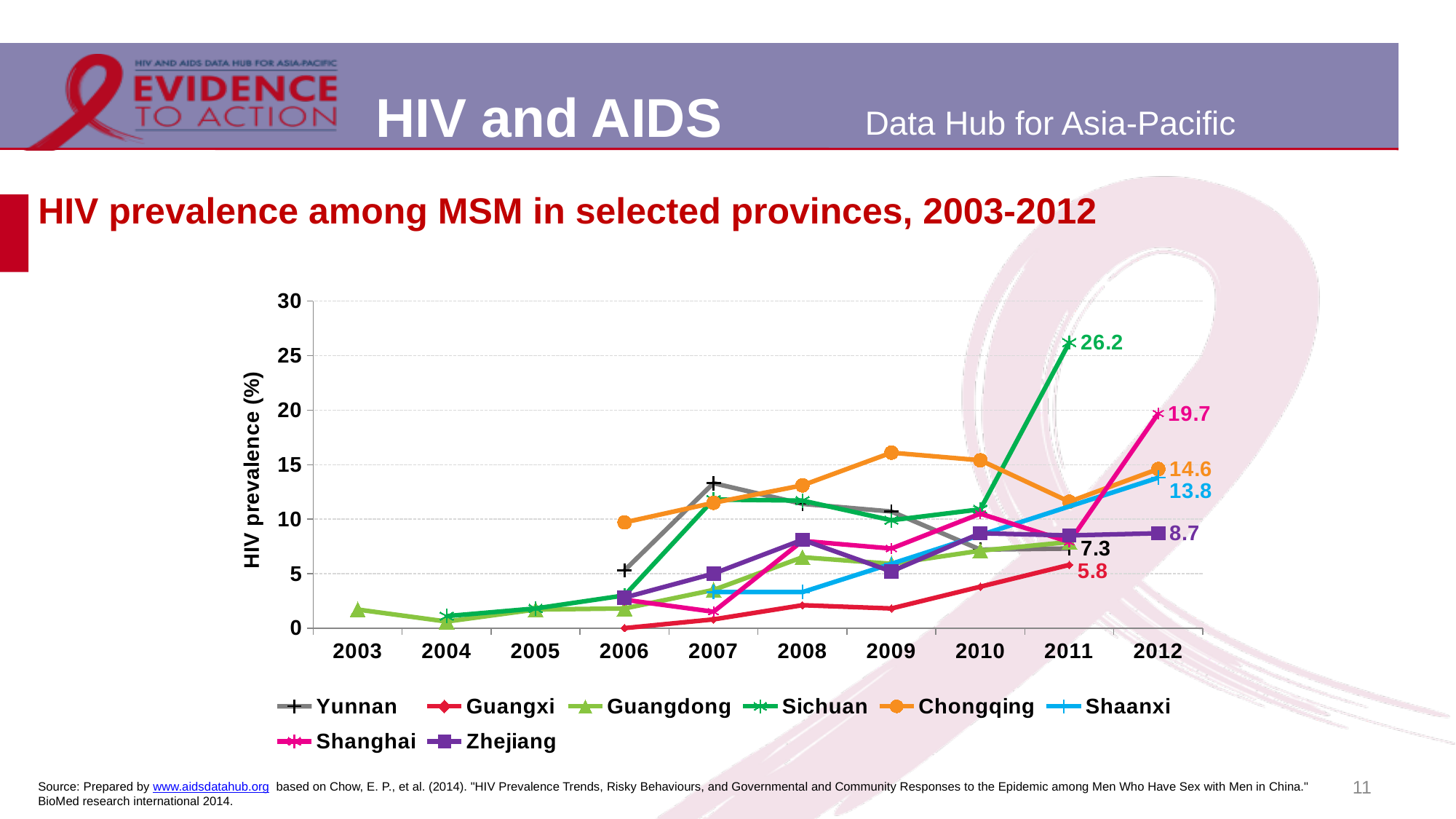
What is the HIV prevalence among MSM in Shanghai in 2012? 19.7 How many provinces are listed in the chart legend? 8 What is the difference between the 2012 values for Shanghai and Chongqing? 5.1 How many years are shown on the x axis? 10 In 2012, which has the higher HIV prevalence, Chongqing or Shaanxi? Chongqing What is the HIV prevalence among MSM in Zhejiang in 2012? 8.7 What kind of chart is shown on the slide? line chart Is the value for Chongqing in 2009 greater or less than 15? greater What is the HIV prevalence among MSM in Sichuan in 2011? 26.2 Which province has the highest labelled HIV prevalence value on the chart? Sichuan What is the HIV prevalence among MSM in Guangxi in 2011? 5.8 What is the label of the y axis? HIV prevalence (%)